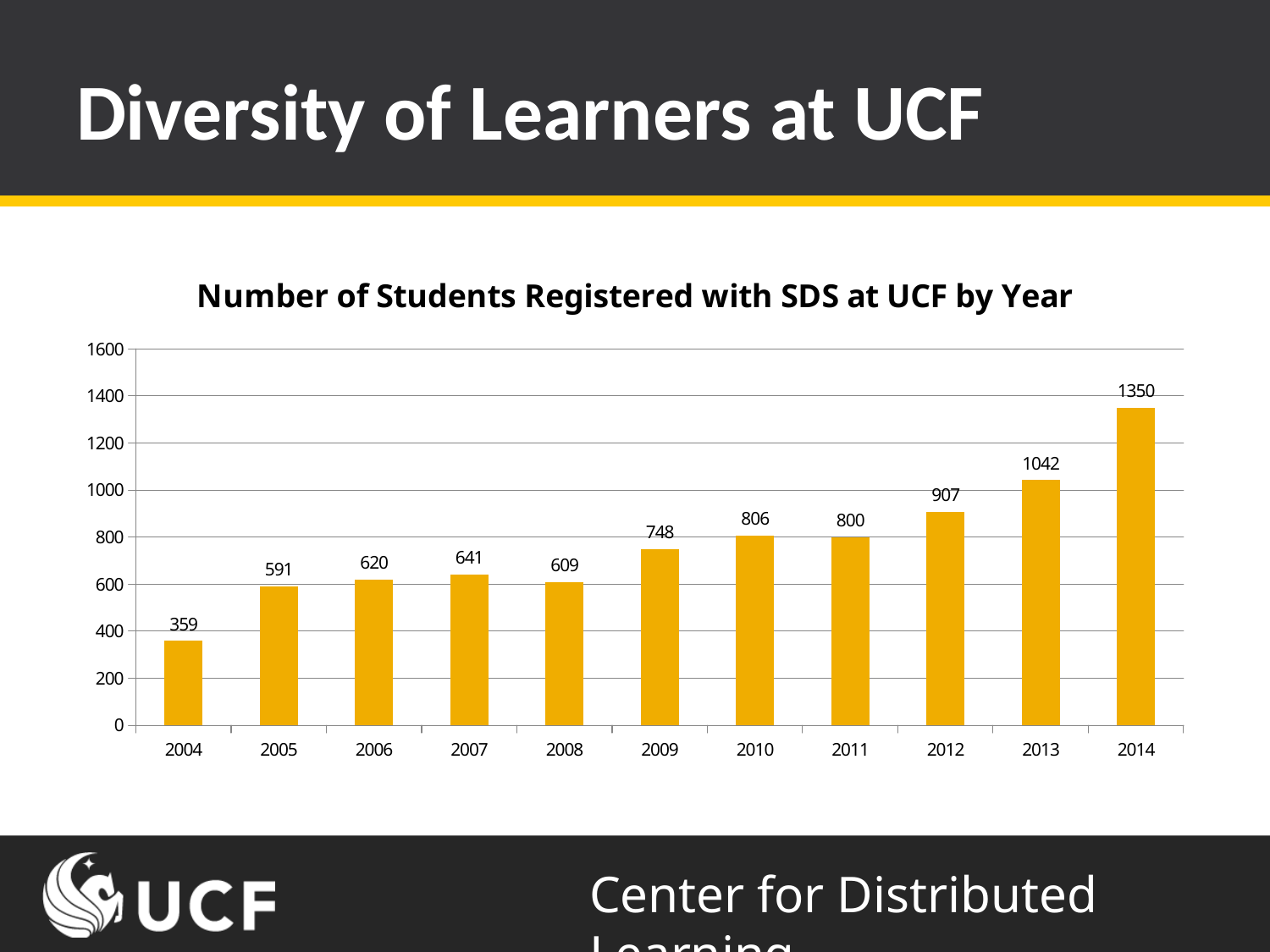
What is the number of students registered with SDS at UCF in 2004? 359 What is the difference between the number of students registered in 2008 and in 2007? 32 What is the title of the chart? Number of Students Registered with SDS at UCF by Year Is the value for 2013 greater or less than 1000? greater What is the number of students registered with SDS at UCF in 2009? 748 Which year has the lowest number of students registered with SDS? 2004 What is the difference between the number of students registered in 2014 and in 2013? 308 Which year had more students registered with SDS, 2010 or 2011? 2010 How many years are shown on the x axis of the chart? 11 Which year has the highest number of students registered with SDS? 2014 What is the number of students registered with SDS at UCF in 2012? 907 What kind of chart is shown on the slide? Bar chart